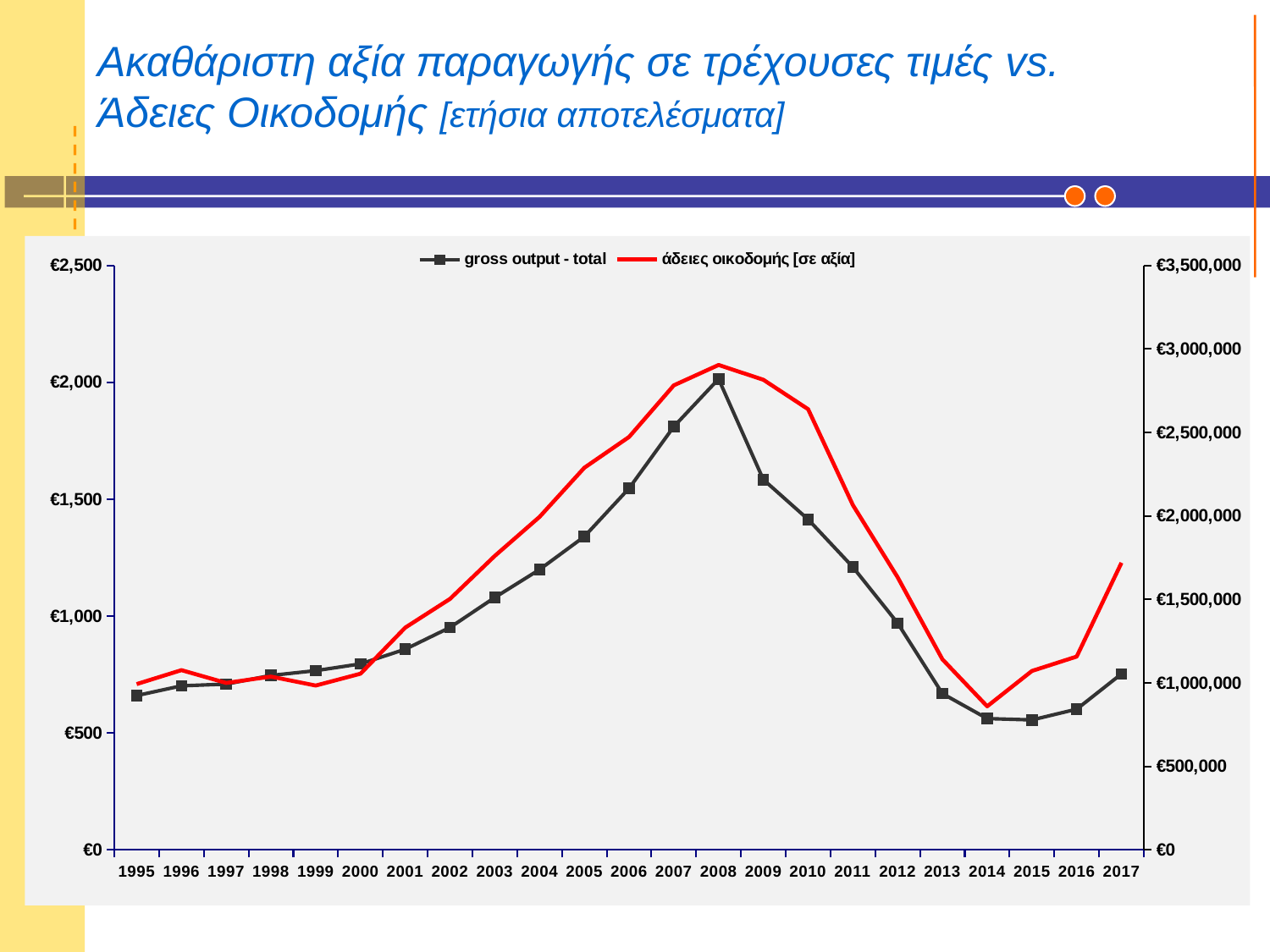
Is the value of 'άδειες οικοδομής [σε αξία]' in 2008 greater or less than €2,500,000? greater Does the 'άδειες οικοδομής [σε αξία]' series rise or fall between 2014 and 2017? rise Is the value of 'άδειες οικοδομής [σε αξία]' in 2017 greater or less than €1,500,000? greater Is the value of 'gross output - total' in 2013 greater or less than €1,000? less What kind of chart is shown on the slide? line chart What is the maximum value shown on the right-hand vertical axis? €3,500,000 How many series does the legend list? 2 Does the 'gross output - total' series rise or fall between 2008 and 2014? fall In which year does the 'άδειες οικοδομής [σε αξία]' series reach its highest value? 2008 In which year does the 'gross output - total' series reach its highest value? 2008 How many years are plotted along the x axis? 23